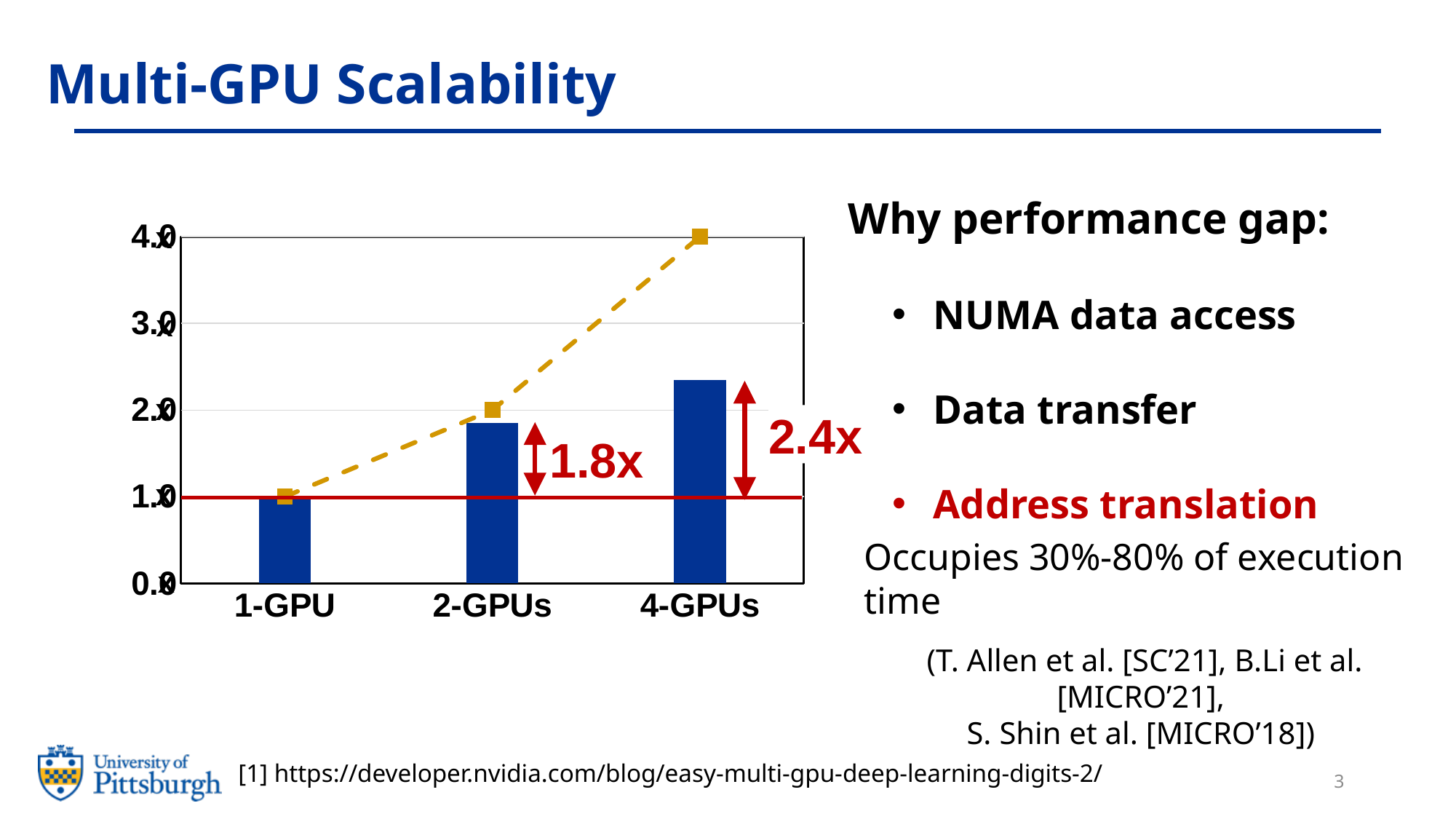
What speedup is annotated for the 4-GPUs bar? 2.4x Is the bar value for 4-GPUs greater or less than 3.0? less Which GPU configuration has the shortest bar? 1-GPU Do the bar values rise or fall as the number of GPUs increases from 1-GPU to 4-GPUs? rise What kind of chart shows the measured speedup for 1-GPU, 2-GPUs and 4-GPUs? bar chart What colour are the bars in the chart? blue Which GPU configuration has the tallest bar? 4-GPUs At 4-GPUs, which is larger: the dashed line point or the bar? the dashed line point What speedup is annotated for the 2-GPUs bar? 1.8x How many GPU configurations are shown on the x axis? 3 Is the bar value for 2-GPUs greater or less than 1.0? greater What value does the dashed line reach at 4-GPUs? 4.0